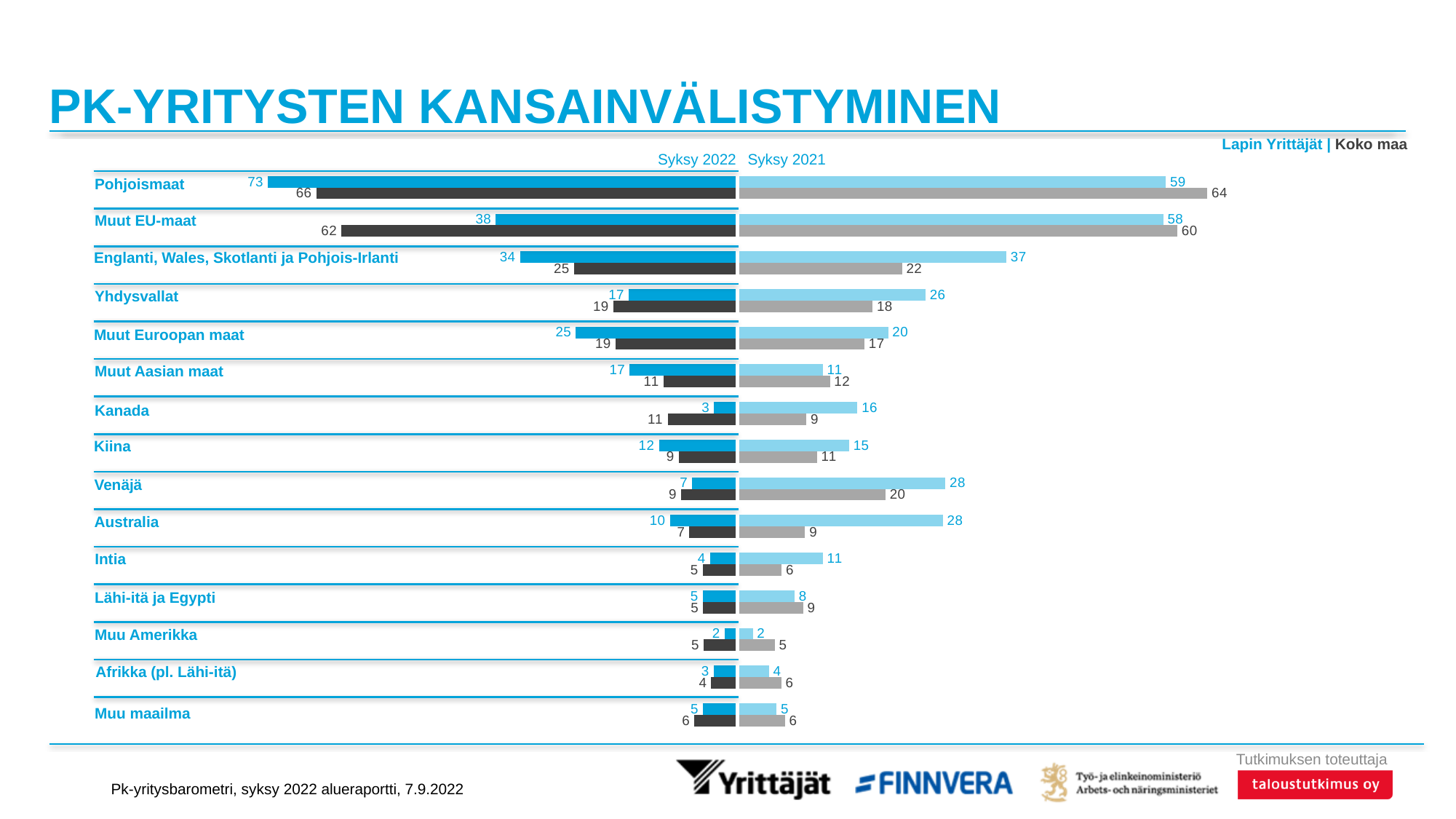
In the Syksy 2022 panel, which is larger for Kanada: the Lapin Yrittäjät value or the Koko maa value? Koko maa What kind of chart is shown on the slide? bar chart Which region has the lowest Lapin Yrittäjät value in the Syksy 2022 panel? Muu Amerikka Which region has the highest Lapin Yrittäjät value in the Syksy 2022 panel? Pohjoismaat In the Syksy 2022 panel, what is the value for Lapin Yrittäjät for Pohjoismaat? 73 In the Syksy 2022 panel, what is the difference between the Lapin Yrittäjät and Koko maa values for Muut EU-maat? 24 In the Syksy 2021 panel, what is the Lapin Yrittäjät value for Venäjä? 28 How many categories (regions) are listed in the chart? 15 In the Syksy 2021 panel, what is the Koko maa value for Englanti, Wales, Skotlanti ja Pohjois-Irlanti? 22 Which two series does the chart legend list? Lapin Yrittäjät and Koko maa For Australia, what is the difference between the Lapin Yrittäjät values in Syksy 2021 and Syksy 2022? 18 In the Syksy 2022 panel, what is the Koko maa value for Muut EU-maat? 62